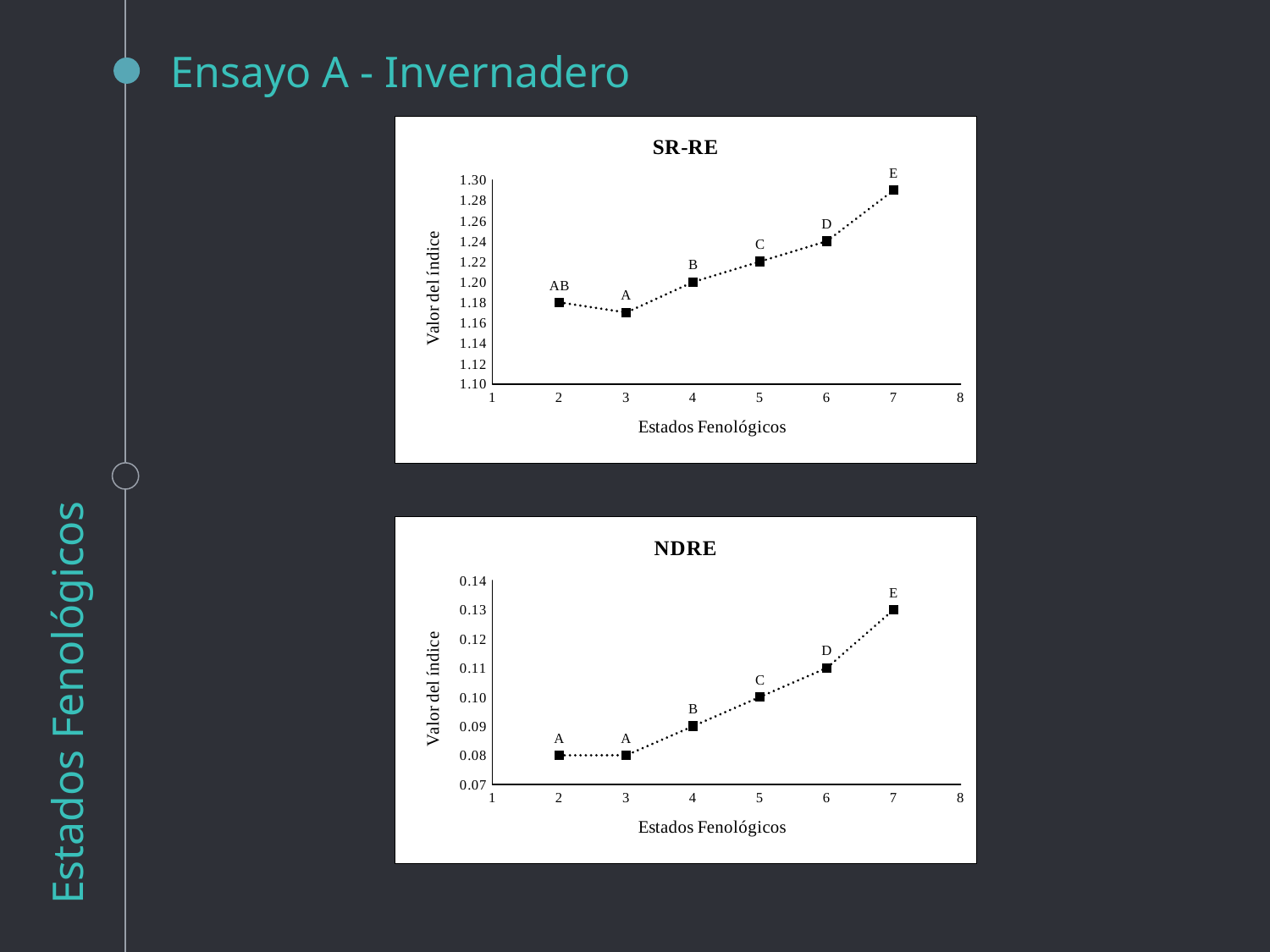
In the NDRE chart, what is the index value at Estado Fenológico 5? 0.10 In the NDRE chart, do the values generally rise or fall as Estados Fenológicos increase from 2 to 7? rise In the SR-RE chart, is the value at Estado Fenológico 7 greater or less than 1.26? greater In the SR-RE chart, is the value at Estado Fenológico 3 greater or less than 1.18? less In the NDRE chart, what is the index value at Estado Fenológico 7? 0.13 In the SR-RE chart, at which Estado Fenológico is the index value highest? 7 In the NDRE chart, what is the difference between the index value at Estado Fenológico 7 and at Estado Fenológico 2? 0.05 In the SR-RE chart, at which Estado Fenológico is the index value lowest? 3 In the SR-RE chart, what letter label is shown above the point at Estado Fenológico 7? E In the NDRE chart, which has the larger index value: Estado Fenológico 4 or Estado Fenológico 6? Estado Fenológico 6 In the NDRE chart, how many data points are plotted? 6 What kind of chart is the SR-RE chart? line chart